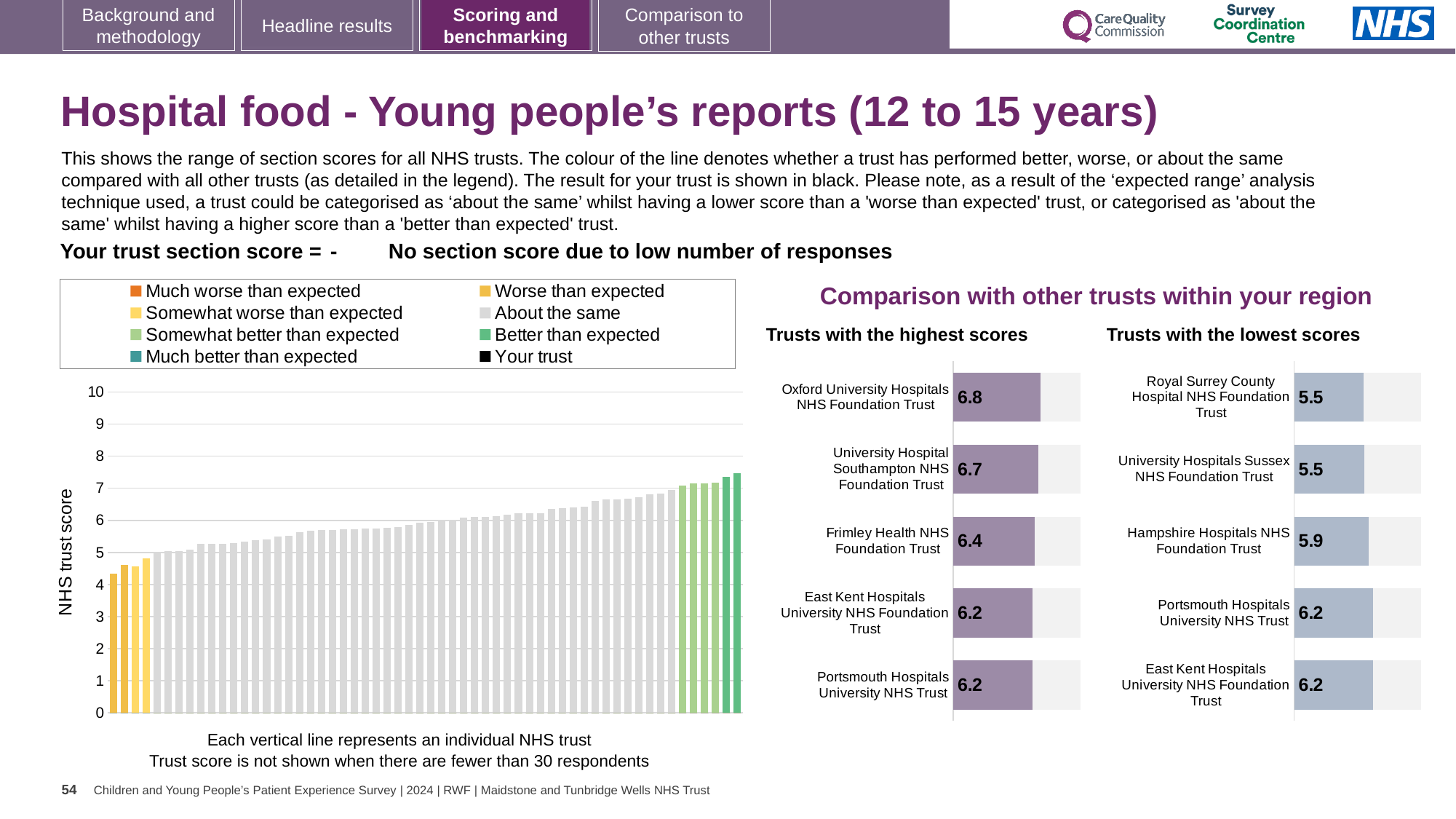
In the 'Trusts with the highest scores' chart, which is larger: the score for University Hospital Southampton NHS Foundation Trust or the score for East Kent Hospitals University NHS Foundation Trust? University Hospital Southampton NHS Foundation Trust In the 'Trusts with the highest scores' chart, what is the score for Frimley Health NHS Foundation Trust? 6.4 In the 'NHS trust score' chart on the left, do the bar values rise or fall from left to right? Rise What kind of chart is the 'NHS trust score' chart on the left of the slide? Bar chart In the 'Trusts with the highest scores' chart, what is the difference between the scores of Oxford University Hospitals NHS Foundation Trust and Frimley Health NHS Foundation Trust? 0.4 In the 'Trusts with the highest scores' chart, which trust has the highest score? Oxford University Hospitals NHS Foundation Trust How many trusts are shown in the 'Trusts with the lowest scores' chart? 5 In the 'Trusts with the lowest scores' chart, what is the score for Hampshire Hospitals NHS Foundation Trust? 5.9 In the 'Trusts with the highest scores' chart, what is the score for Oxford University Hospitals NHS Foundation Trust? 6.8 In the 'Trusts with the lowest scores' chart, what is the difference between the scores of Portsmouth Hospitals University NHS Trust and Royal Surrey County Hospital NHS Foundation Trust? 0.7 In the 'Trusts with the lowest scores' chart, what is the score for Royal Surrey County Hospital NHS Foundation Trust? 5.5 In the 'NHS trust score' chart on the left, is the value of the tallest bar greater or less than 7? greater